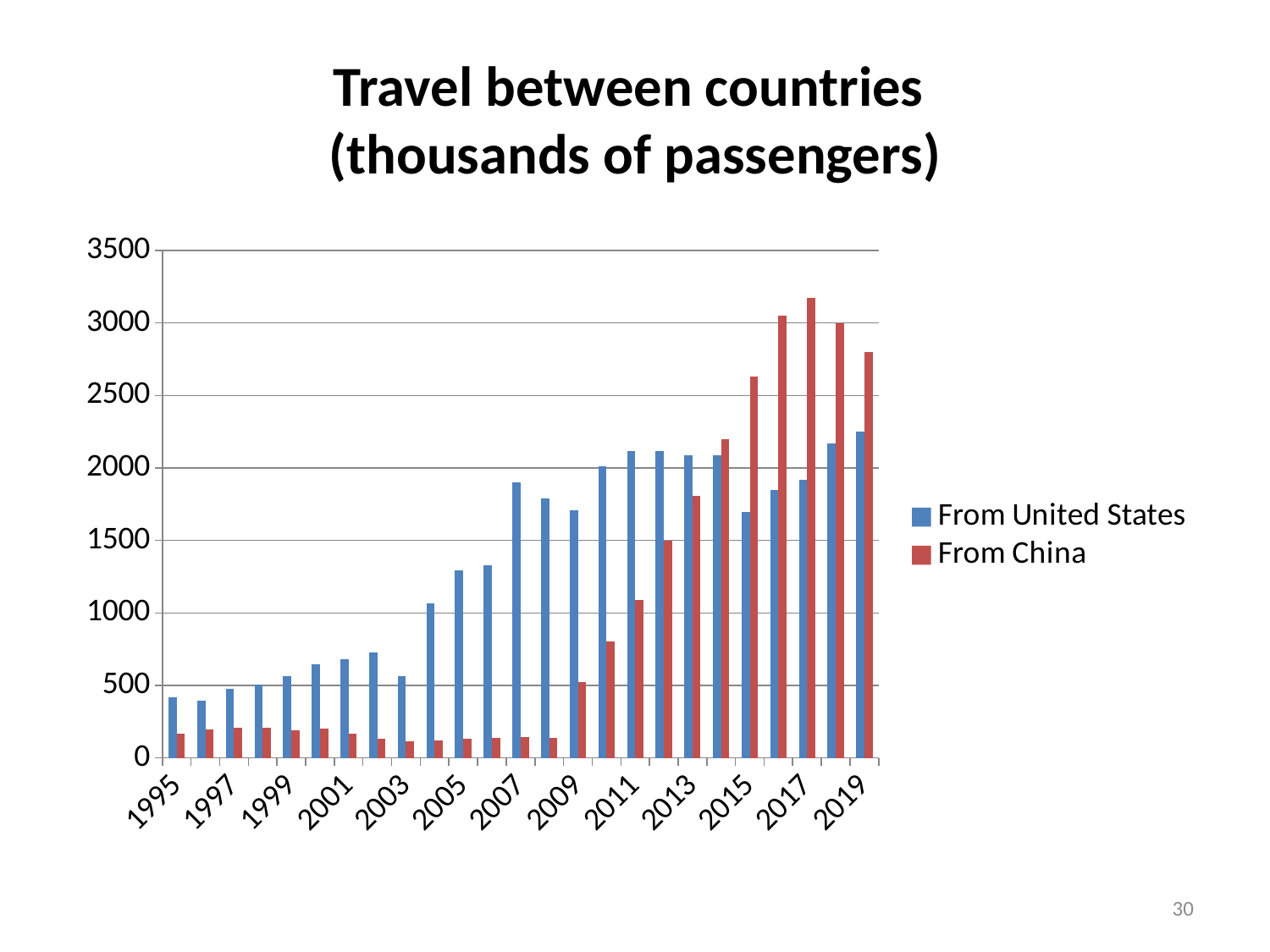
Is the From China value for 2017 greater or less than 3000? greater How many series does the legend list? 2 In 2019, which series has the larger value, From United States or From China? From China In 2009, which series has the larger value, From United States or From China? From United States What kind of chart is shown on the slide? bar chart Which colour represents the From China series in the legend? red Which year has the highest value for the From United States series? 2019 Do the From China values generally rise or fall from 2009 to 2017? rise Is the From China value for 1995 greater or less than 500? less Which year has the highest value for the From China series? 2017 Is the From United States value for 2015 greater or less than 2000? less